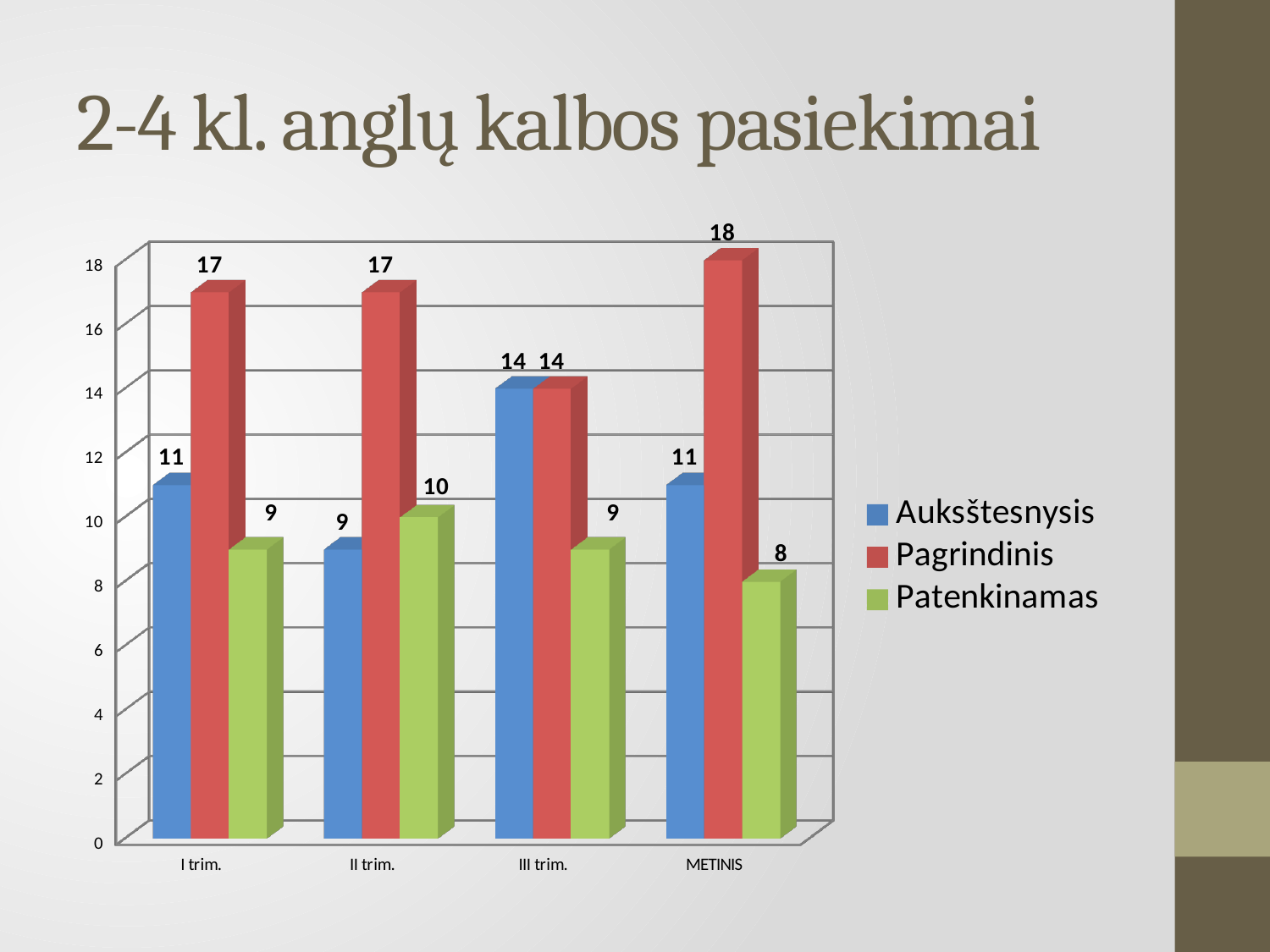
What is the title of the slide? 2-4 kl. anglų kalbos pasiekimai What is the difference between Pagrindinis and Aukštesnysis in I trim.? 6 What is the value for Pagrindinis in METINIS? 18 What kind of chart is shown on the slide? Bar chart How many categories are shown on the x axis? 4 What colour represents the Patenkinamas series? Green What is the value for Aukštesnysis in II trim.? 9 How many series does the legend list? 3 What is the value for Patenkinamas in III trim.? 9 Which category has the highest value for Pagrindinis? METINIS Which category has the lowest value for Patenkinamas? METINIS Which is larger in III trim.: Aukštesnysis or Patenkinamas? Aukštesnysis